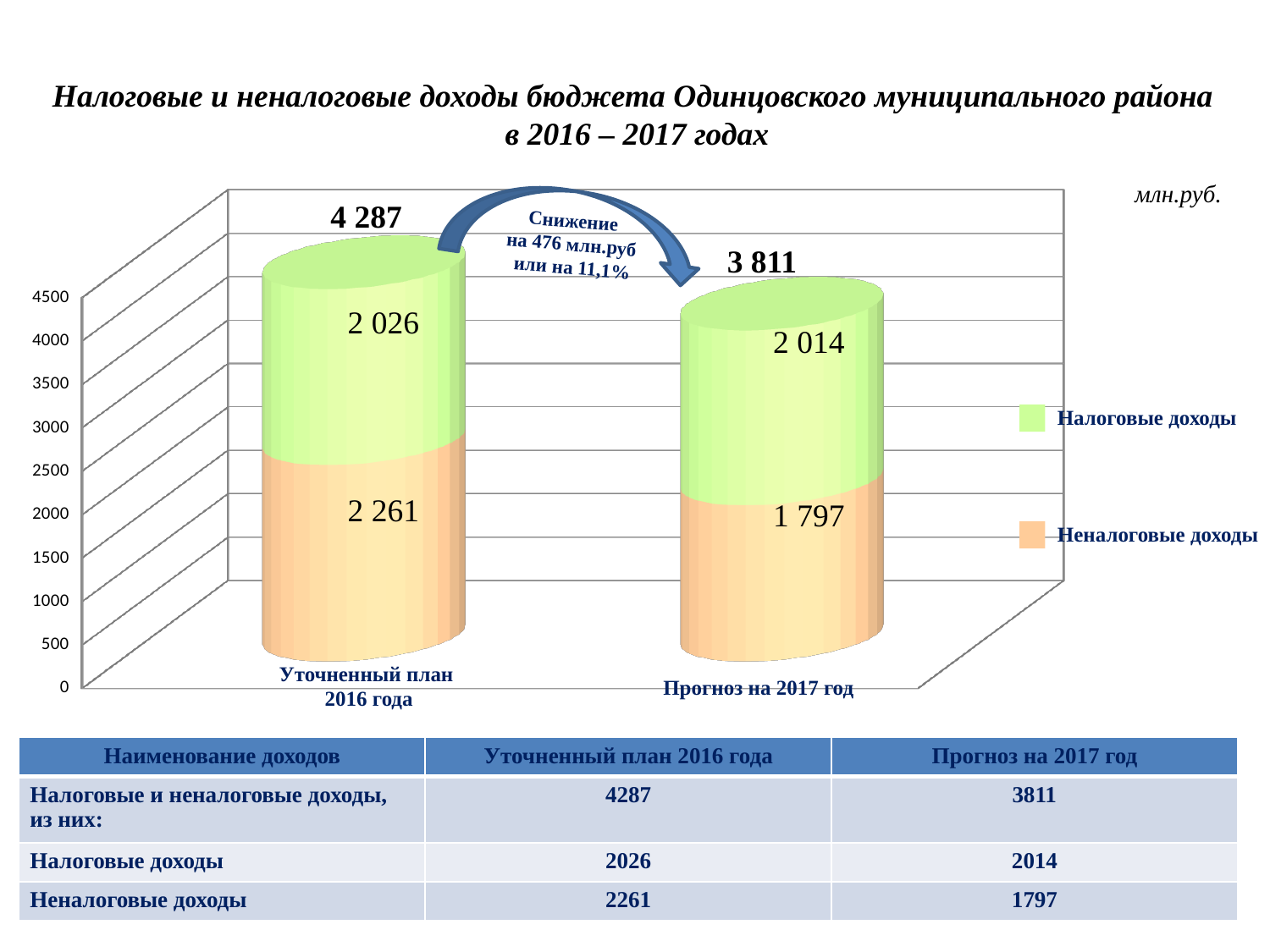
What is the total of the stacked bar for Уточненный план 2016 года? 4 287 Which category has the higher total: Уточненный план 2016 года or Прогноз на 2017 год? Уточненный план 2016 года What is the value of Неналоговые доходы for Уточненный план 2016 года? 2 261 What is the difference between Неналоговые доходы in 2016 and Неналоговые доходы in 2017? 464 Which colour represents Налоговые доходы in the chart? Green What is the value of Неналоговые доходы for Прогноз на 2017 год? 1 797 What is the difference between the total for Уточненный план 2016 года and the total for Прогноз на 2017 год? 476 What is the value of Налоговые доходы for Уточненный план 2016 года? 2 026 How many series does the legend list? 2 What kind of chart is shown on the slide? Stacked bar chart What is the total of the stacked bar for Прогноз на 2017 год? 3 811 Which is larger for Уточненный план 2016 года: Налоговые доходы or Неналоговые доходы? Неналоговые доходы